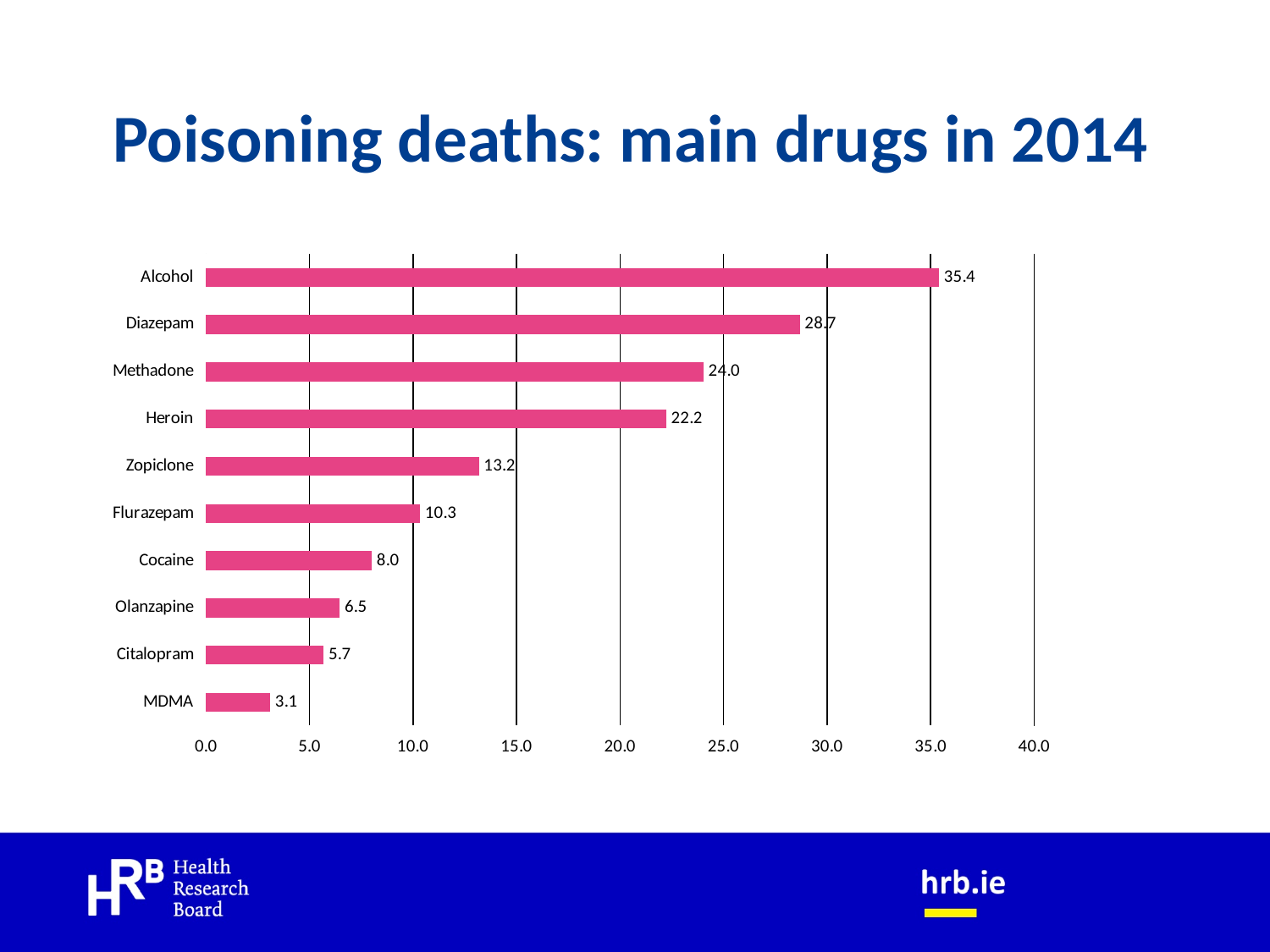
What is the value for Methadone? 24.0 What kind of chart is shown on the slide? Bar chart What is the difference between the values for Alcohol and Diazepam? 6.7 Is the value for Diazepam greater or less than 25.0? greater How many drugs are shown in the chart? 10 What is the difference between the values for Heroin and Zopiclone? 9.0 Which drug has the lowest value? MDMA Which has a larger value, Cocaine or Olanzapine? Cocaine Which drug has the highest value? Alcohol What is the value for Flurazepam? 10.3 What is the title of the slide? Poisoning deaths: main drugs in 2014 What is the value for Alcohol? 35.4